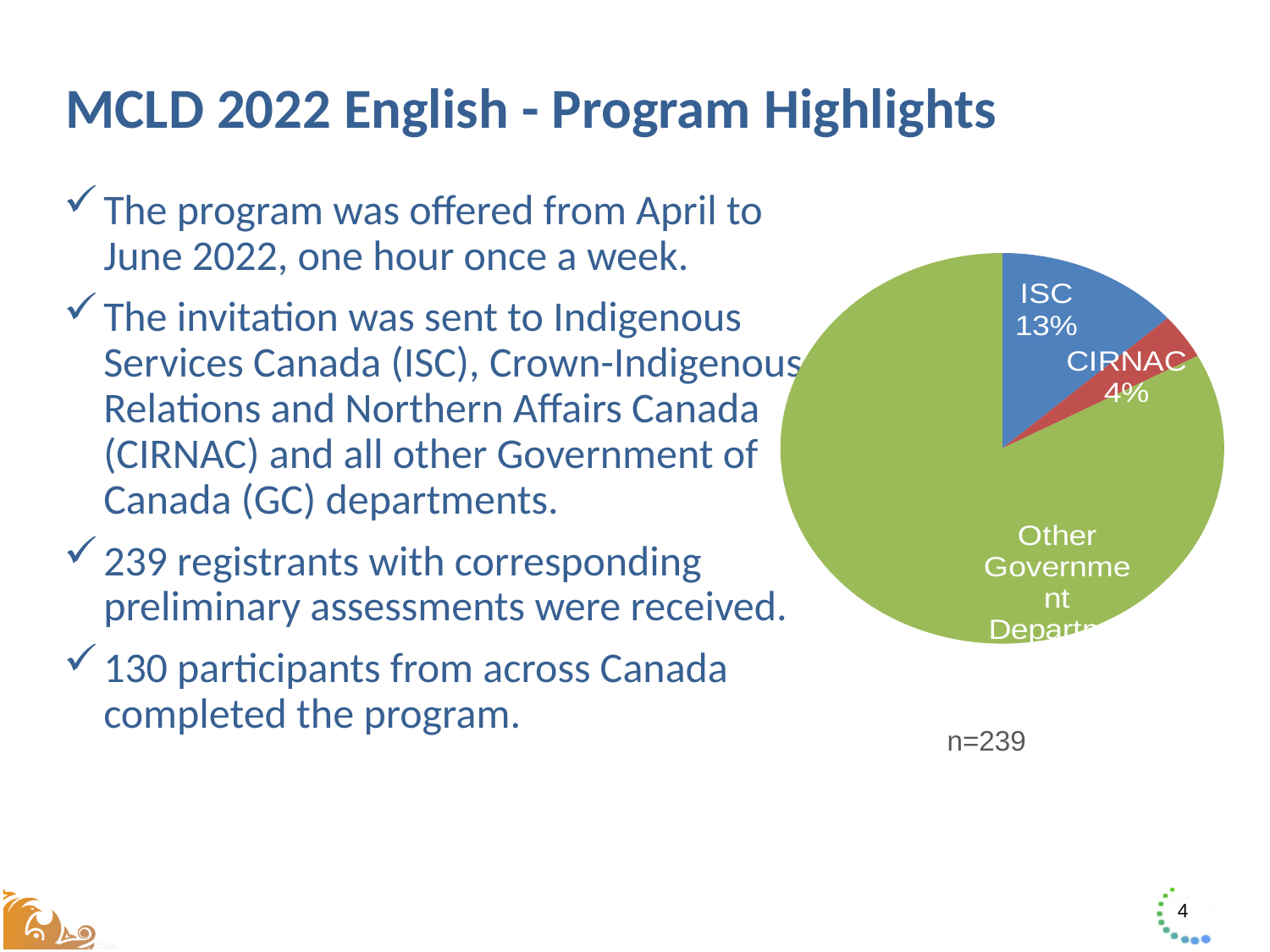
What colour is the ISC slice in the pie chart? Blue What kind of chart is shown on the slide? Pie chart By how many percentage points does the ISC share exceed the CIRNAC share? 9 percentage points What is the sample size (n) noted below the pie chart? n=239 Which category has the largest slice in the pie chart? Other Government Departments Which category has the smallest slice in the pie chart? CIRNAC How many slices does the pie chart have? 3 Is the ISC share of the pie chart greater or less than 10%? greater What percentage of the pie chart does CIRNAC represent? 4% Which slice is larger in the pie chart, ISC or CIRNAC? ISC What percentage of the pie chart does ISC represent? 13%